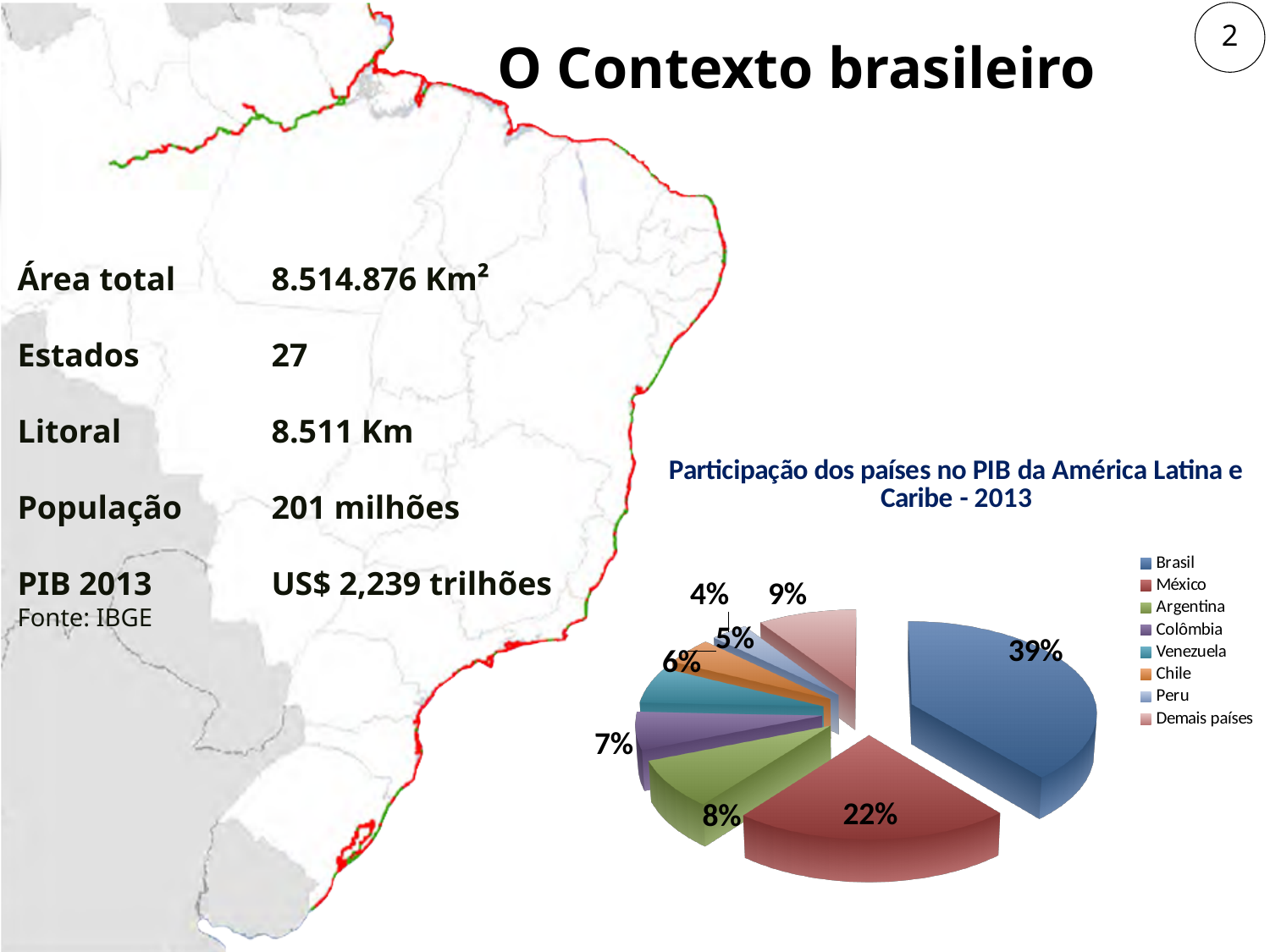
Which is larger, the share of Argentina or the share of Demais países? Demais países Which country has the largest slice of the pie? Brasil What kind of chart is shown on the slide? pie chart What share of the pie does Venezuela have? 6% What share of the pie does Demais países have? 9% What share of the pie does Brasil have? 39% How many entries does the legend of the pie chart list? 8 What is the title of the pie chart? Participação dos países no PIB da América Latina e Caribe - 2013 What is the difference between the shares of Brasil and México? 17%